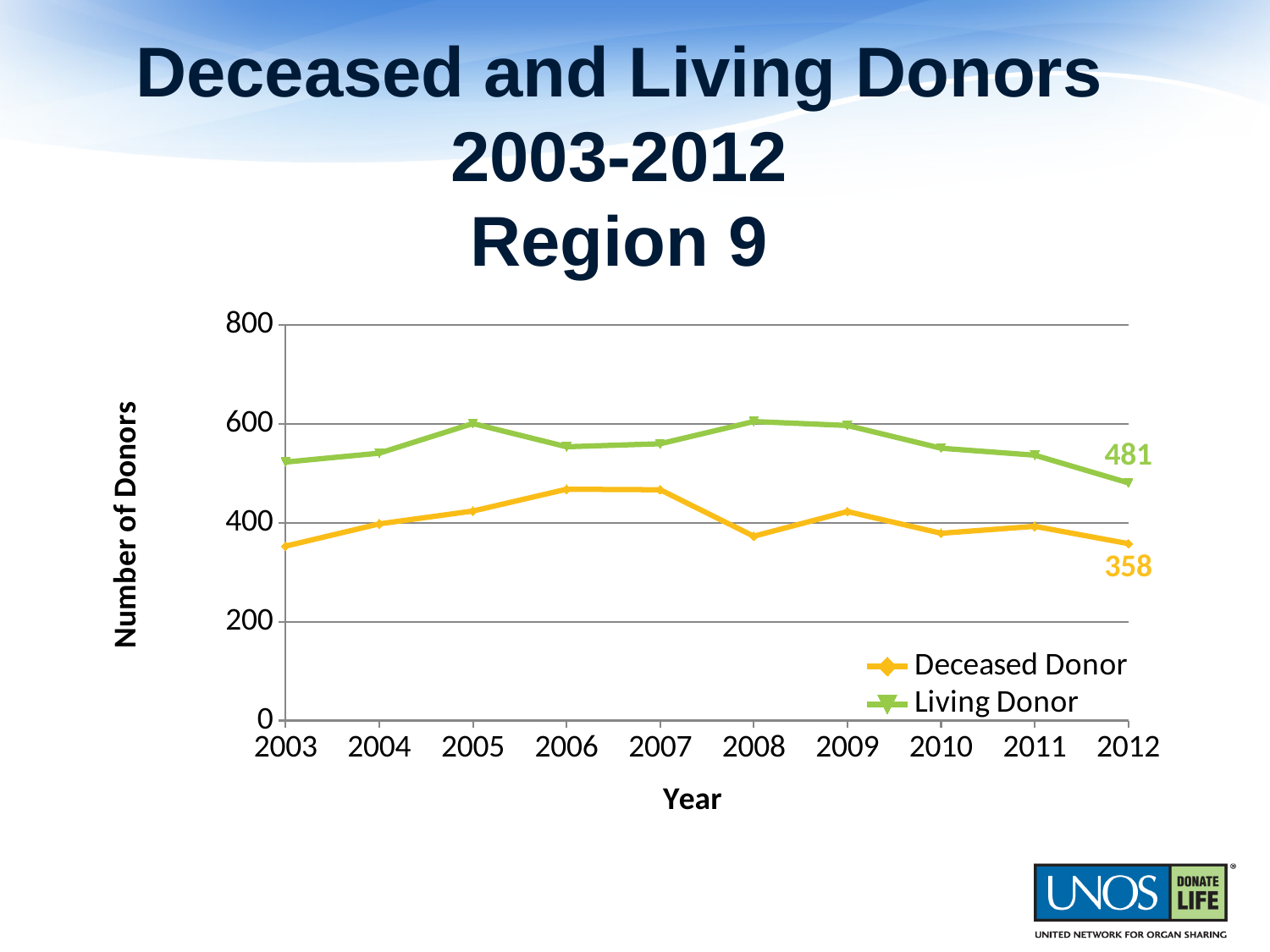
Is the value for Living Donor in 2003 greater or less than 600? less What kind of chart is shown on the slide? line chart What is the value for Deceased Donor in 2012? 358 How many series does the legend list? 2 What is the title of the y axis? Number of Donors How many years are shown on the x axis? 10 What is the difference between the Living Donor and Deceased Donor values in 2012? 123 Is the value for Deceased Donor in 2003 greater or less than 400? less What is the value for Living Donor in 2012? 481 Does the Living Donor series rise or fall from 2009 to 2012? fall Is the value for Deceased Donor in 2006 greater or less than 400? greater In 2012, which series has the larger value, Living Donor or Deceased Donor? Living Donor